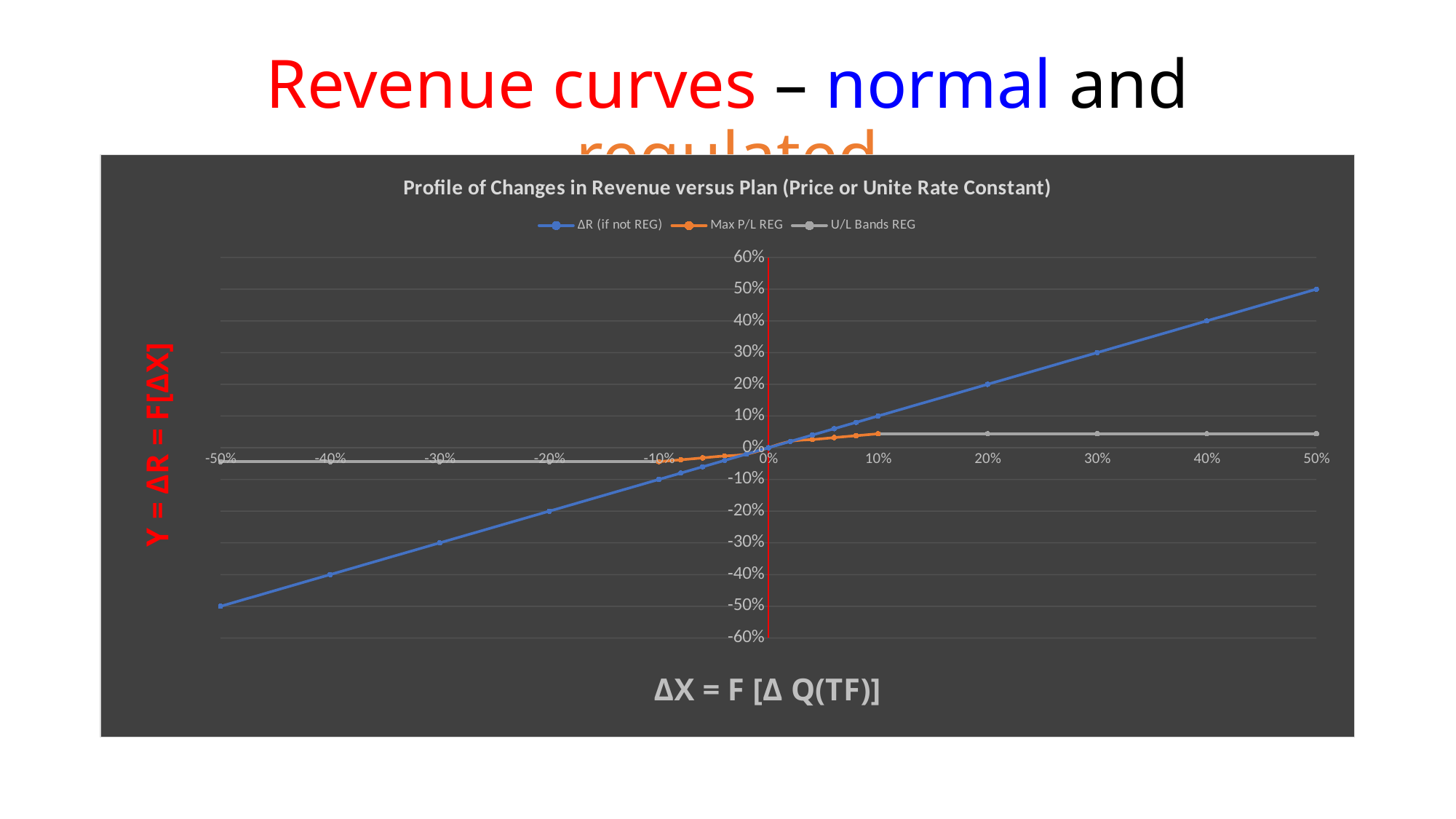
Does the ΔR (if not REG) series rise or fall as the x axis goes from -50% to 50%? rise What is the value of the ΔR (if not REG) series at -20% on the x axis? -20% What is the title of the chart? Profile of Changes in Revenue versus Plan (Price or Unite Rate Constant) Is the value of the U/L Bands REG series at -30% on the x axis greater or less than -10%? greater Which series is drawn in blue? ΔR (if not REG) What kind of chart is shown on the slide? line chart Is the value of the U/L Bands REG series at 30% on the x axis greater or less than 10%? less What is the value of the ΔR (if not REG) series at 50% on the x axis? 50% How many series does the chart legend list? 3 What is the value of the ΔR (if not REG) series at 30% on the x axis? 30% At 40% on the x axis, which series has the larger value: ΔR (if not REG) or U/L Bands REG? ΔR (if not REG) What is the value of the ΔR (if not REG) series at -50% on the x axis? -50%